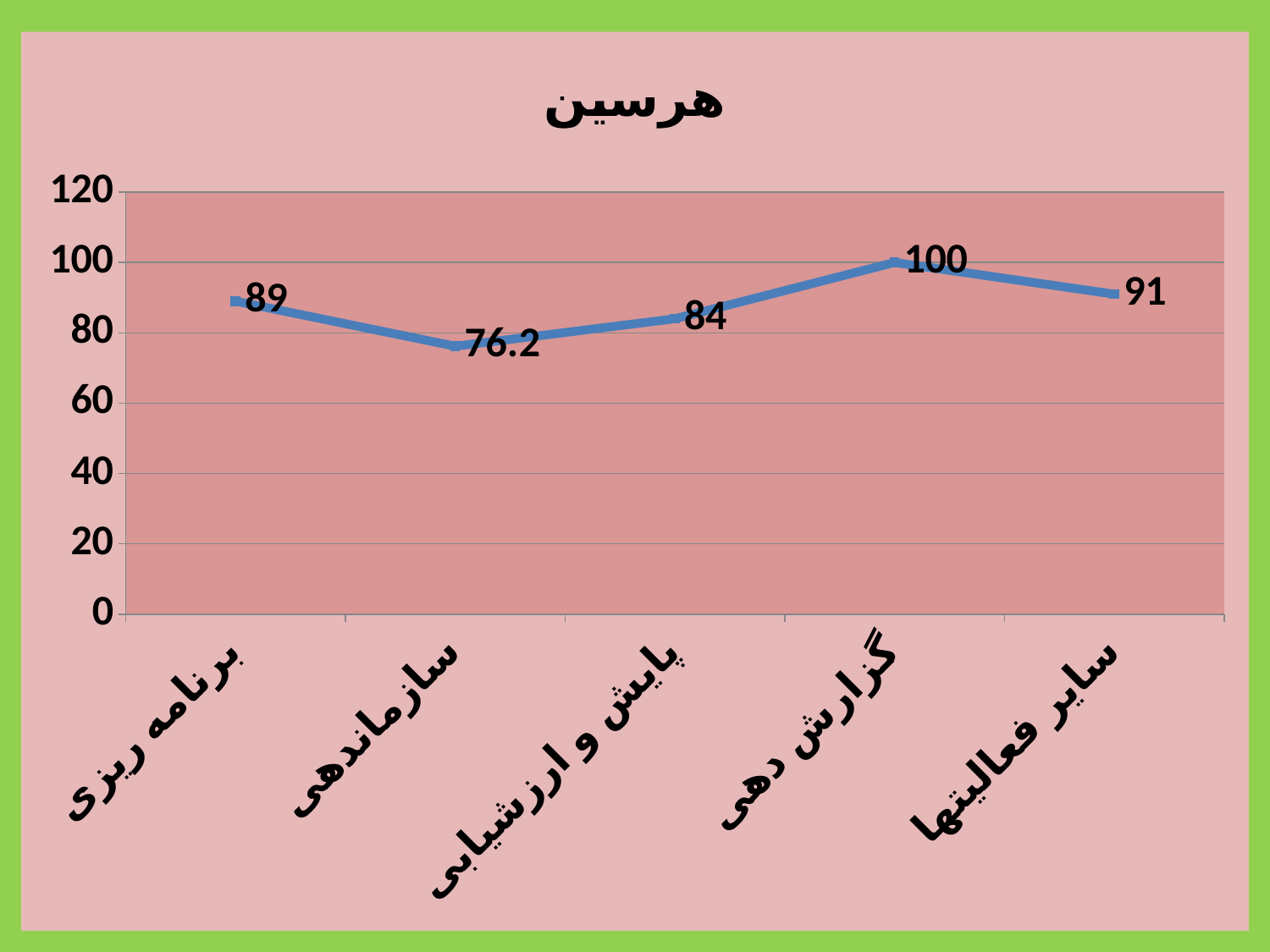
What kind of chart is shown? line chart What is the value for برنامه ریزی? 89 Which category has the lowest value? سازماندهی How many categories are plotted on the x axis? 5 What is the title of the chart? هرسین Which is larger, the value for سایر فعالیتها or the value for برنامه ریزی? سایر فعالیتها What is the value for گزارش دهی? 100 What is the value for پایش و ارزشیابی? 84 What is the value for سازماندهی? 76.2 What is the value for سایر فعالیتها? 91 Which category has the highest value? گزارش دهی What is the difference between the values for گزارش دهی and سازماندهی? 23.8